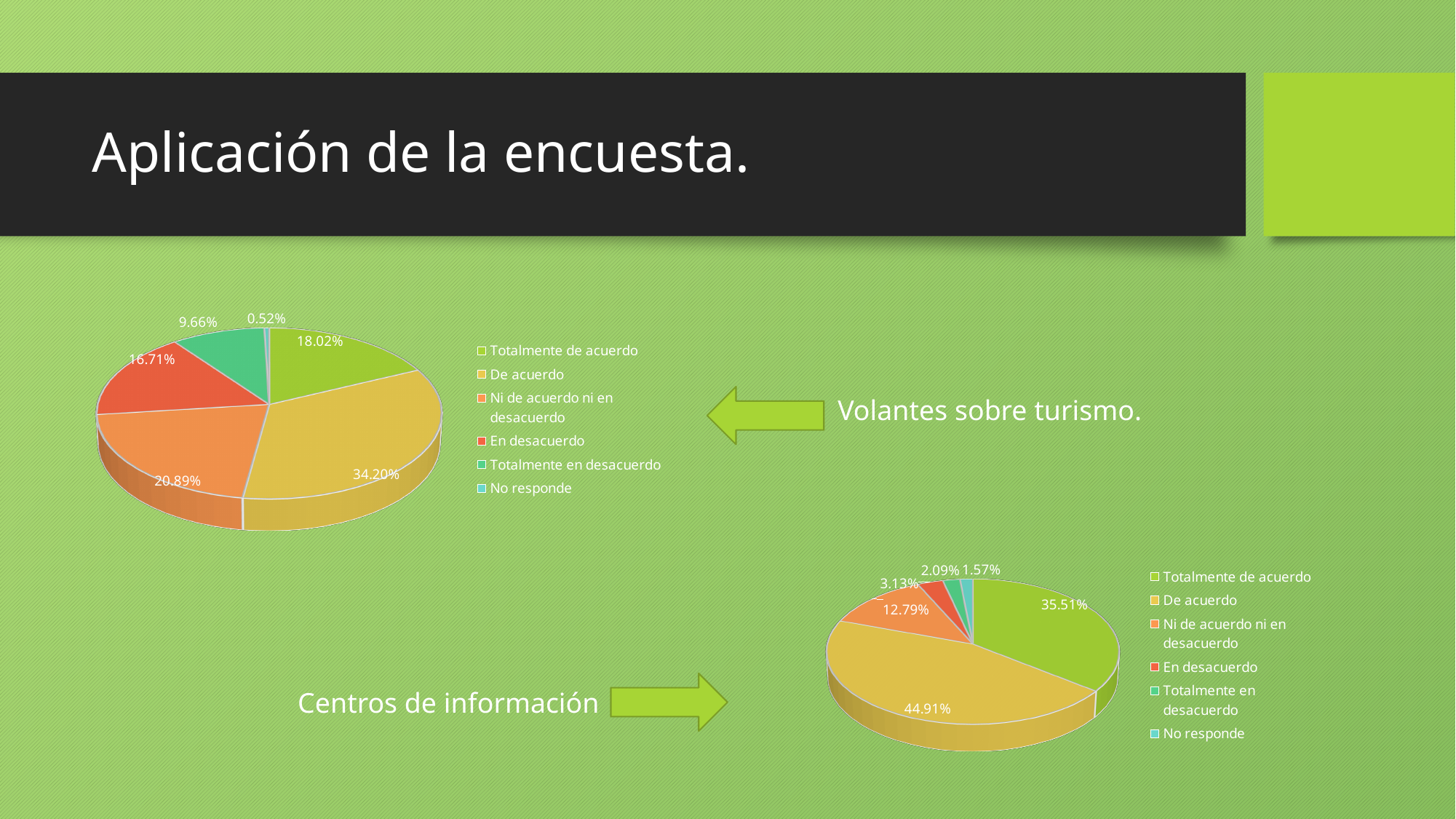
Which chart has the larger 'De acuerdo' share: 'Volantes sobre turismo' or 'Centros de información'? Centros de información In the 'Volantes sobre turismo' pie chart, what is the difference between the 'De acuerdo' and 'Totalmente de acuerdo' shares? 16.18% In the 'Centros de información' pie chart, which is larger: 'Ni de acuerdo ni en desacuerdo' or 'En desacuerdo'? Ni de acuerdo ni en desacuerdo What type of chart is used for 'Volantes sobre turismo'? Pie chart In the 'Centros de información' pie chart, what share is labelled for 'Totalmente de acuerdo'? 35.51% How many categories does the legend of the 'Centros de información' pie chart list? 6 In the 'Volantes sobre turismo' pie chart, what share is labelled for 'De acuerdo'? 34.20% In the 'Volantes sobre turismo' pie chart, what share is labelled for 'Totalmente en desacuerdo'? 9.66% In the 'Volantes sobre turismo' pie chart, which category has the largest slice? De acuerdo In the 'Centros de información' pie chart, which category has the largest slice? De acuerdo In the 'Volantes sobre turismo' pie chart, which category has the smallest slice? No responde In the 'Centros de información' pie chart, what share is labelled for 'En desacuerdo'? 3.13%